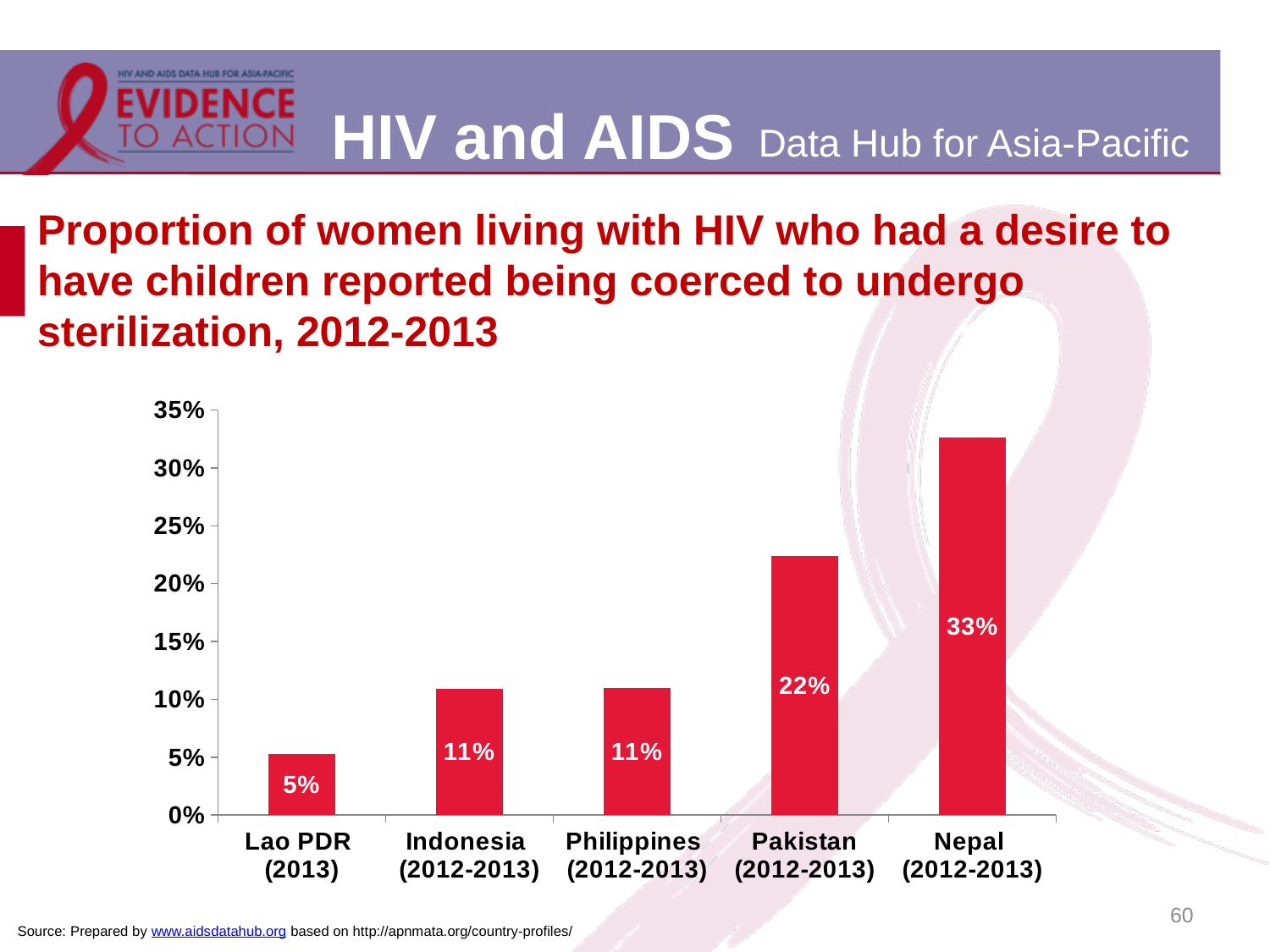
Which country has the lowest proportion? Lao PDR (2013) What is the difference between the values for Indonesia and Lao PDR? 6% What is the difference between the values for Nepal and Pakistan? 11% What is the value for Indonesia (2012-2013)? 11% How many countries are shown in the chart? 5 What is the value for Lao PDR (2013)? 5% Which country has the highest proportion? Nepal (2012-2013) What kind of chart is shown on the slide? bar chart Which is larger, the value for Pakistan or the value for Philippines? Pakistan What is the value for Pakistan (2012-2013)? 22% Is the value for Pakistan greater or less than 20%? greater What is the value for Nepal (2012-2013)? 33%